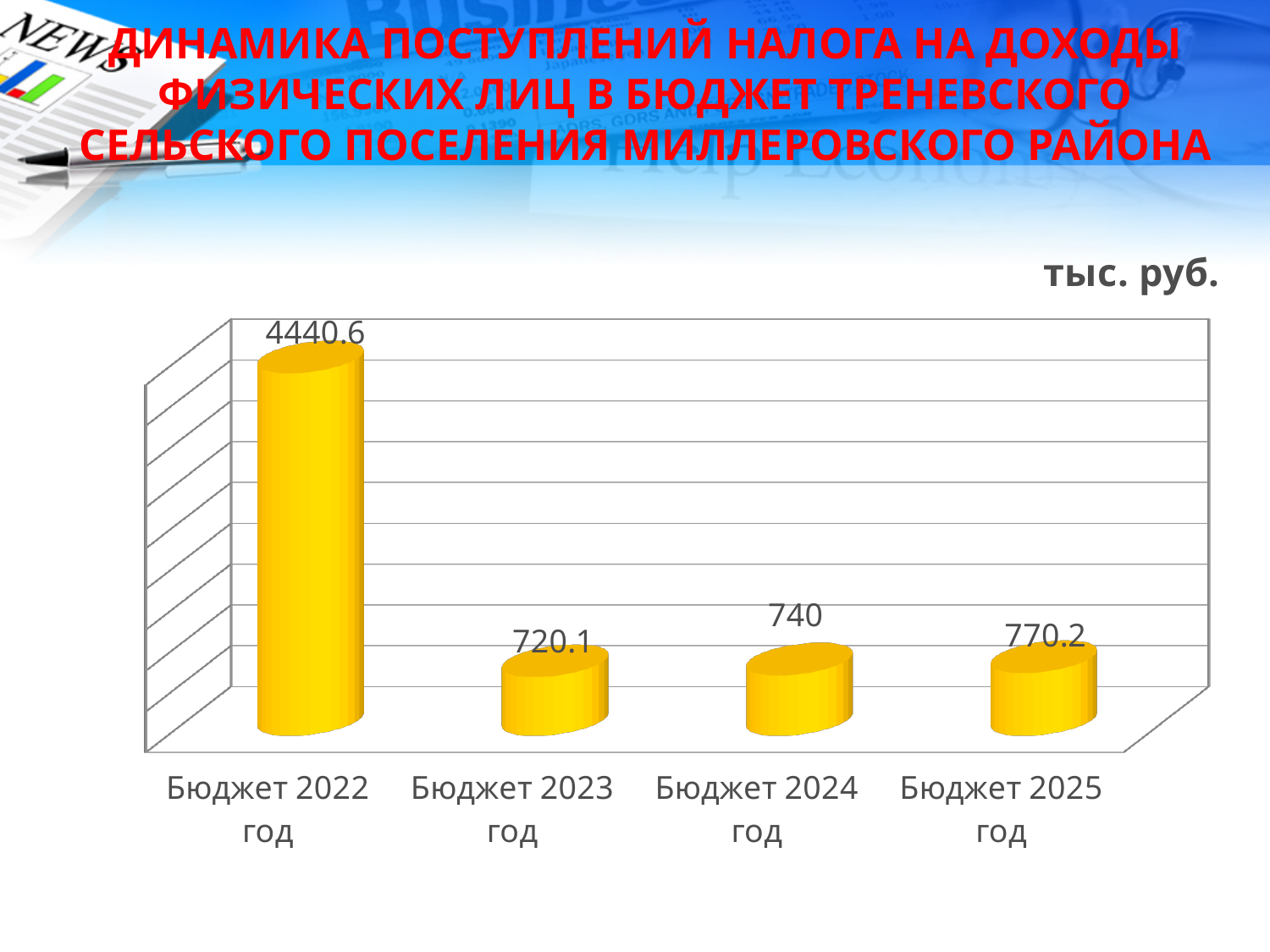
Which is larger, the value for Бюджет 2022 год or the value for Бюджет 2025 год? Бюджет 2022 год What is the difference between the values for Бюджет 2022 год and Бюджет 2023 год? 3720.5 What is the value for Бюджет 2024 год? 740 What is the value for Бюджет 2025 год? 770.2 What is the value for Бюджет 2023 год? 720.1 Which category has the highest value? Бюджет 2022 год How many categories are shown on the chart? 4 Which category has the lowest value? Бюджет 2023 год What is the difference between the values for Бюджет 2025 год and Бюджет 2024 год? 30.2 What unit of measurement is indicated above the chart? тыс. руб. What is the value for Бюджет 2022 год? 4440.6 What kind of chart is shown on the slide? bar chart